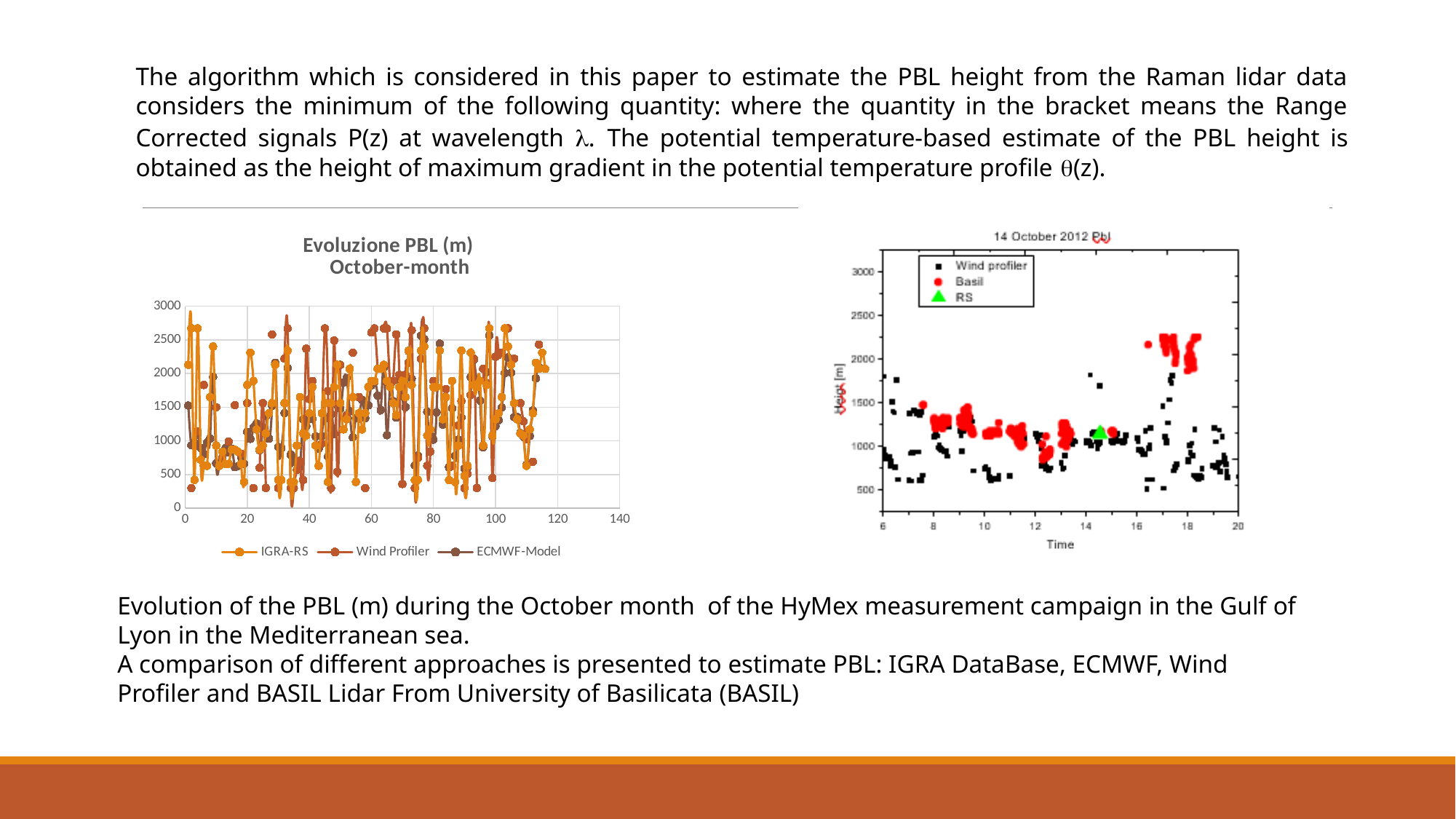
How many series does the legend of the left chart 'Evoluzione PBL (m) October-month' list? 3 What are the series names in the legend of the right chart '14 October 2012 PBL'? Wind profiler, Basil, RS What is the maximum value shown on the y axis of the left chart 'Evoluzione PBL (m) October-month'? 3000 In the right chart '14 October 2012 PBL', are the Basil values at time 18 greater or less than 1500? greater In the right chart '14 October 2012 PBL', is the RS value (green triangle) greater or less than 1500? less In the right chart '14 October 2012 PBL', which series has the highest values around time 17 to 18, Basil or Wind profiler? Basil What kind of chart is the left chart titled 'Evoluzione PBL (m) October-month'? line chart What are the series names in the legend of the left chart 'Evoluzione PBL (m) October-month'? IGRA-RS, Wind Profiler, ECMWF-Model In the right chart '14 October 2012 PBL', are the Basil values at time 8 greater or less than 2000? less How many series does the legend of the right chart '14 October 2012 PBL' list? 3 What kind of chart is the right chart titled '14 October 2012 PBL'? scatter plot